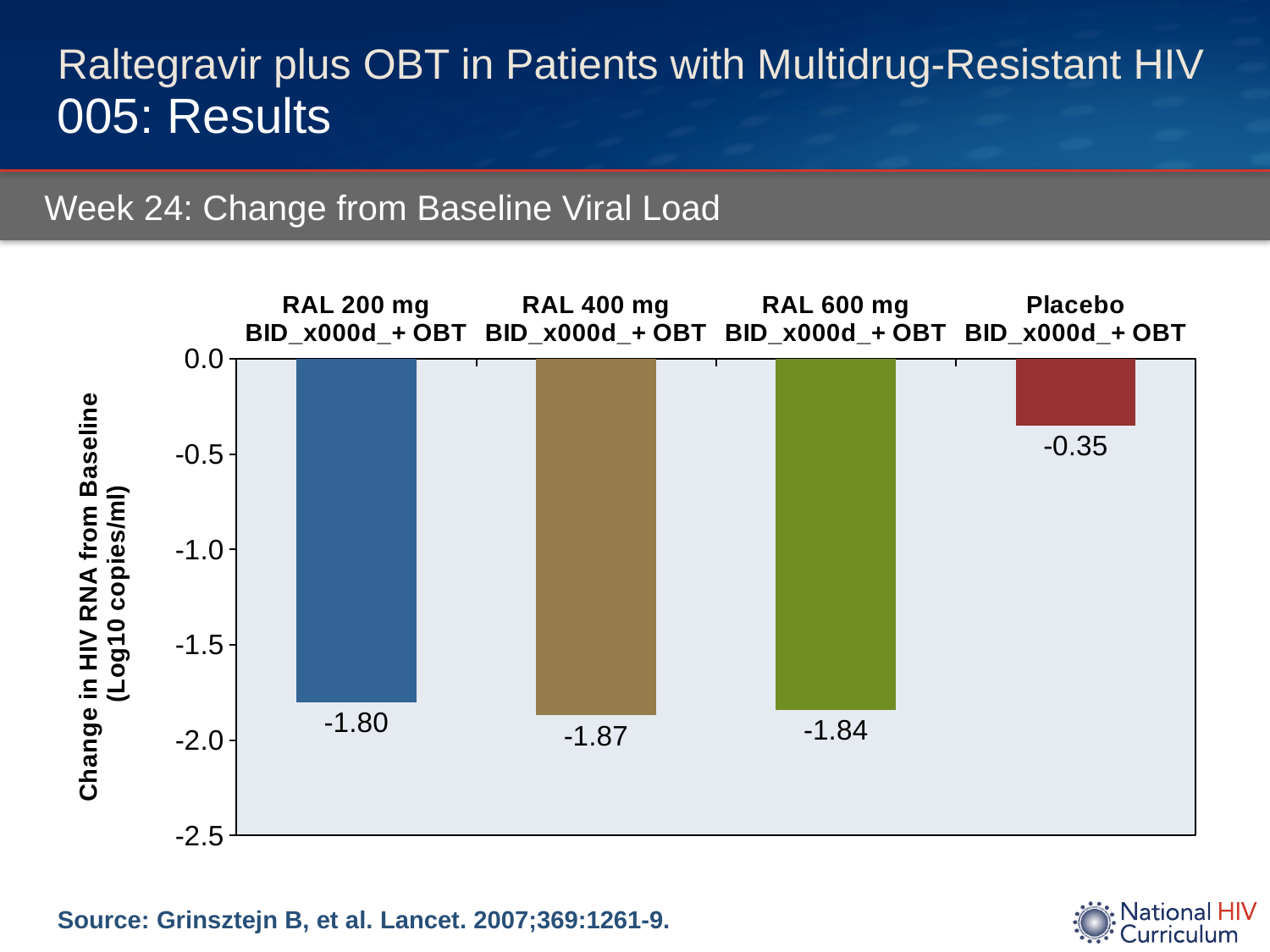
How much larger is the decrease from baseline for RAL 400 mg BID + OBT than for Placebo + OBT? 1.52 What is the change in HIV RNA from baseline for RAL 400 mg BID + OBT? -1.87 Which group shows the smallest decrease in HIV RNA from baseline? Placebo + OBT What is the difference between the values for RAL 200 mg BID + OBT and RAL 600 mg BID + OBT? 0.04 What is the label of the vertical axis? Change in HIV RNA from Baseline (Log10 copies/ml) What is the change in HIV RNA from baseline for RAL 600 mg BID + OBT? -1.84 How many treatment groups are shown in the chart? 4 Which group has a greater decrease in viral load: RAL 200 mg BID + OBT or Placebo + OBT? RAL 200 mg BID + OBT Which group shows the largest decrease in HIV RNA from baseline? RAL 400 mg BID + OBT What type of chart is shown on the slide? Bar chart What is the change in HIV RNA from baseline for Placebo + OBT? -0.35 What is the change in HIV RNA from baseline for RAL 200 mg BID + OBT? -1.80